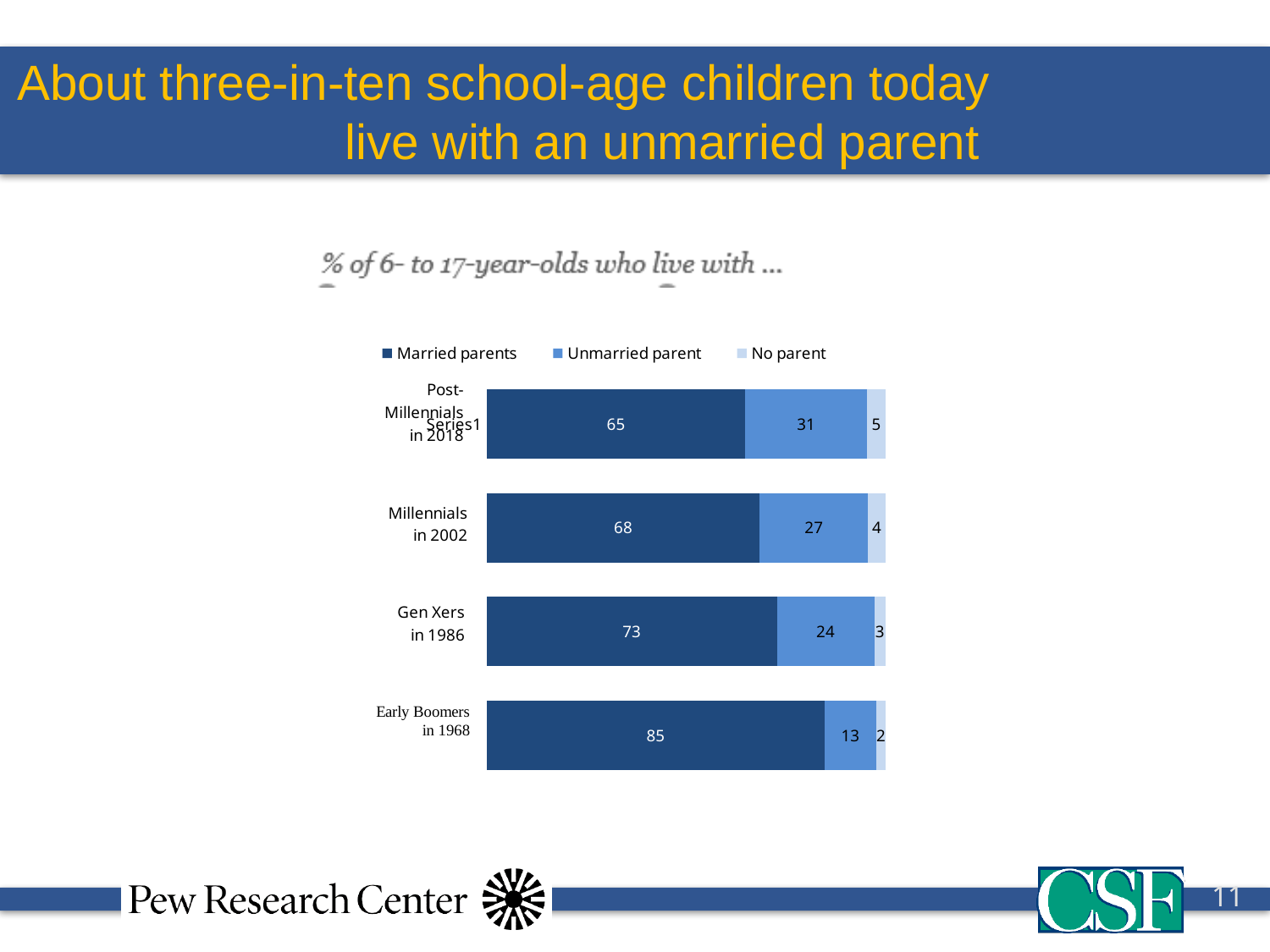
What is the difference between the Married parents values for Early Boomers in 1968 and Post-Millennials in 2018? 20 How many generation categories are shown in the chart? 4 How many series does the legend list? 3 Which generation has the highest Married parents value? Early Boomers in 1968 Which series is shown in the darkest blue in the legend? Married parents What is the No parent value for Gen Xers in 1986? 3 What kind of chart is shown on the slide? Stacked bar chart What percentage of 6- to 17-year-olds lived with married parents among Millennials in 2002? 68 Which generation has the lowest Unmarried parent value? Early Boomers in 1968 What is the total of the stacked bar for Gen Xers in 1986? 100 Which is larger: the Unmarried parent value for Millennials in 2002 or for Gen Xers in 1986? Millennials in 2002 What is the value for Unmarried parent for Post-Millennials in 2018? 31